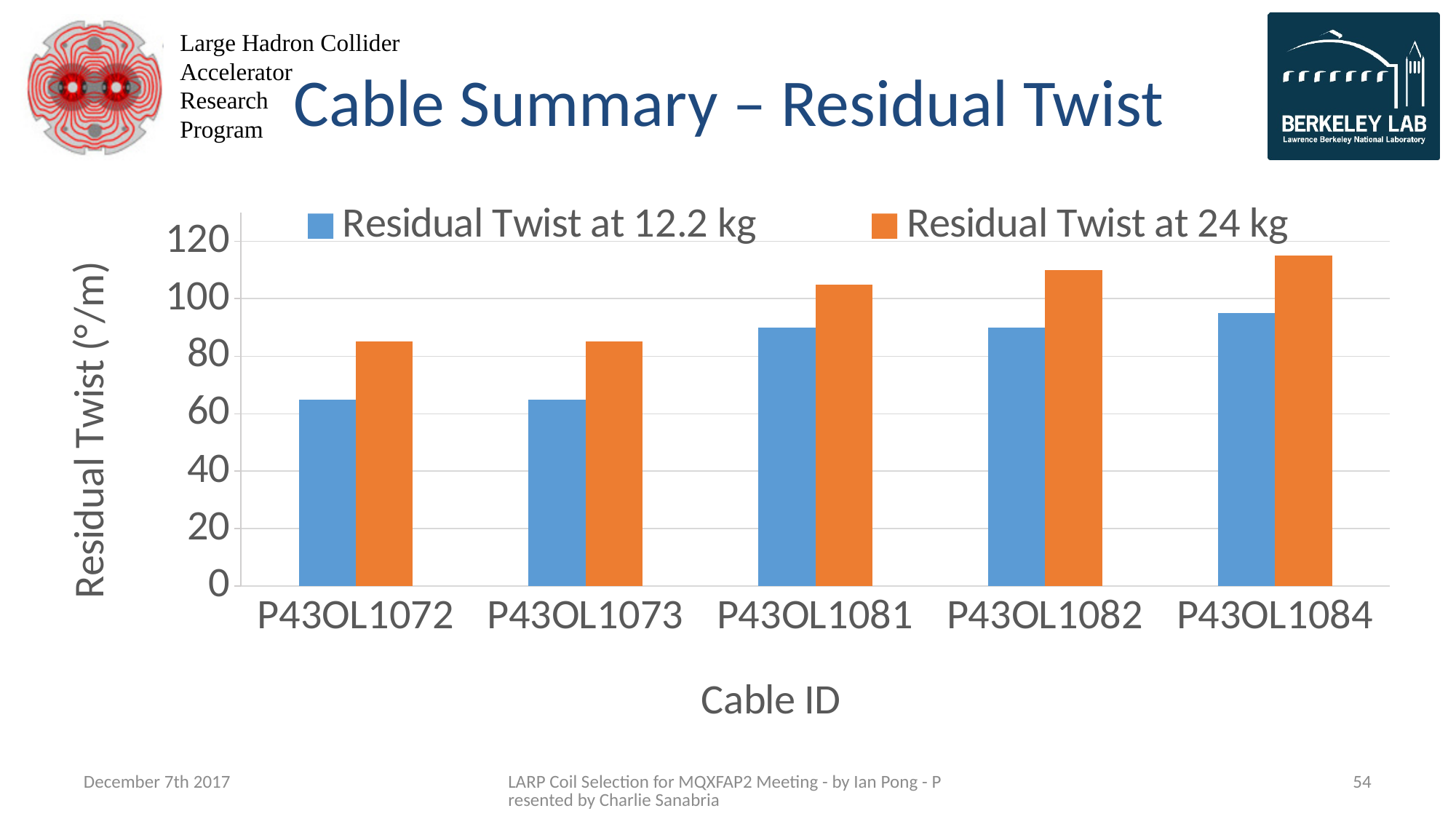
How many cable IDs are shown on the x axis? 5 Do the Residual Twist at 24 kg values rise or fall from P43OL1072 to P43OL1084? rise What is the label of the y axis? Residual Twist (°/m) For P43OL1081, which is larger: the Residual Twist at 12.2 kg or at 24 kg? Residual Twist at 24 kg Is the Residual Twist at 12.2 kg for P43OL1082 greater or less than 100? less Which cable has the highest Residual Twist at 12.2 kg? P43OL1084 What kind of chart is shown on the slide? bar chart Is the Residual Twist at 24 kg for P43OL1073 greater or less than 80? greater Is the Residual Twist at 24 kg for P43OL1084 greater or less than 100? greater How many series does the legend list? 2 Which cable has the highest Residual Twist at 24 kg? P43OL1084